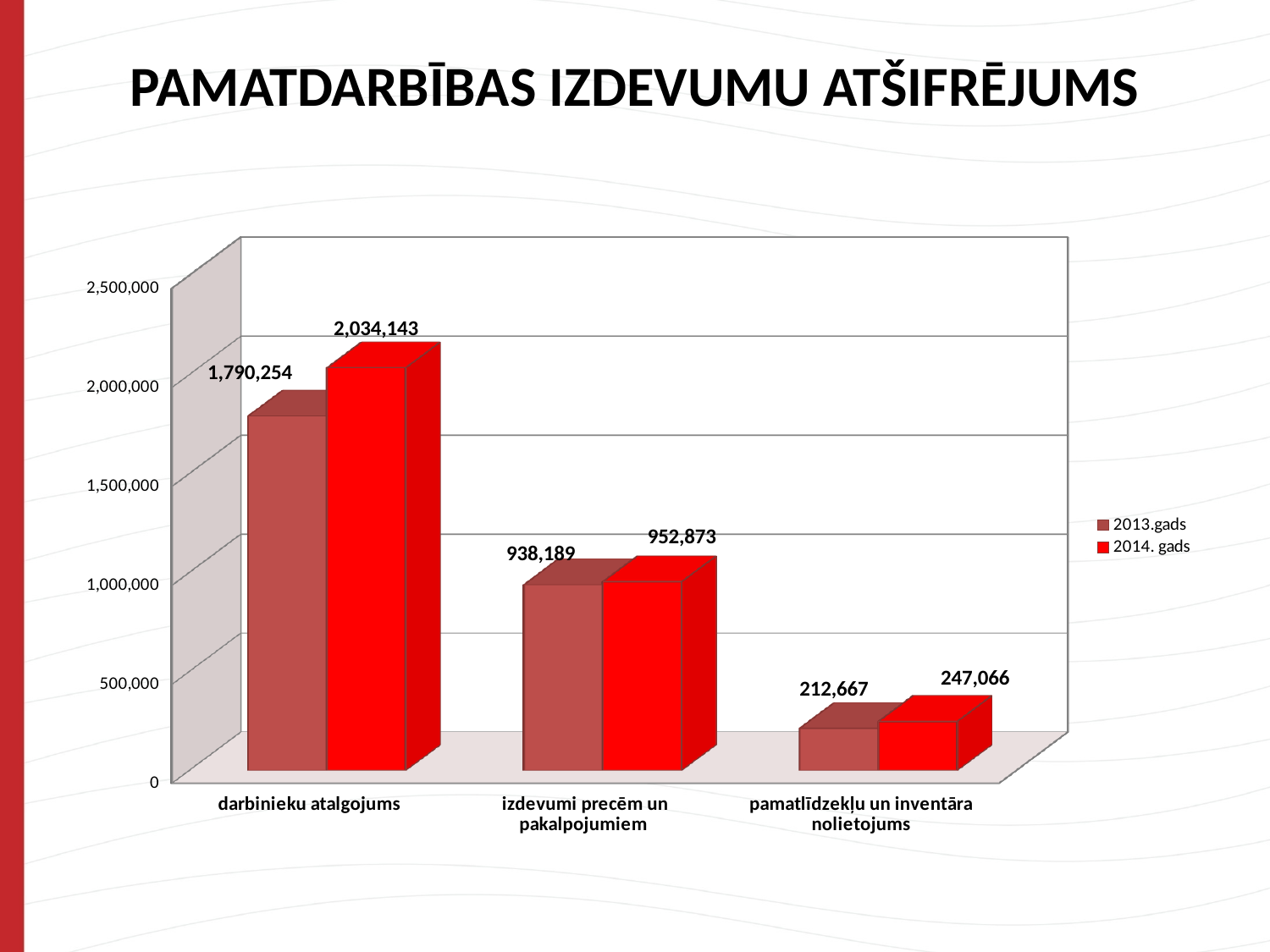
What is the value for darbinieku atalgojums in 2014. gads? 2,034,143 What is the value for pamatlīdzekļu un inventāra nolietojums in 2013.gads? 212,667 How many categories are shown on the x axis? 3 How many series does the legend list? 2 What is the difference between the 2014. gads and 2013.gads values for pamatlīdzekļu un inventāra nolietojums? 34,399 Which is larger for izdevumi precēm un pakalpojumiem: the 2013.gads value or the 2014. gads value? 2014. gads Which category has the highest value in 2014. gads? darbinieku atalgojums What is the value for darbinieku atalgojums in 2013.gads? 1,790,254 What is the value for izdevumi precēm un pakalpojumiem in 2014. gads? 952,873 What is the difference between the 2014. gads and 2013.gads values for darbinieku atalgojums? 243,889 Which category has the lowest value in 2013.gads? pamatlīdzekļu un inventāra nolietojums What kind of chart is shown on the slide? bar chart